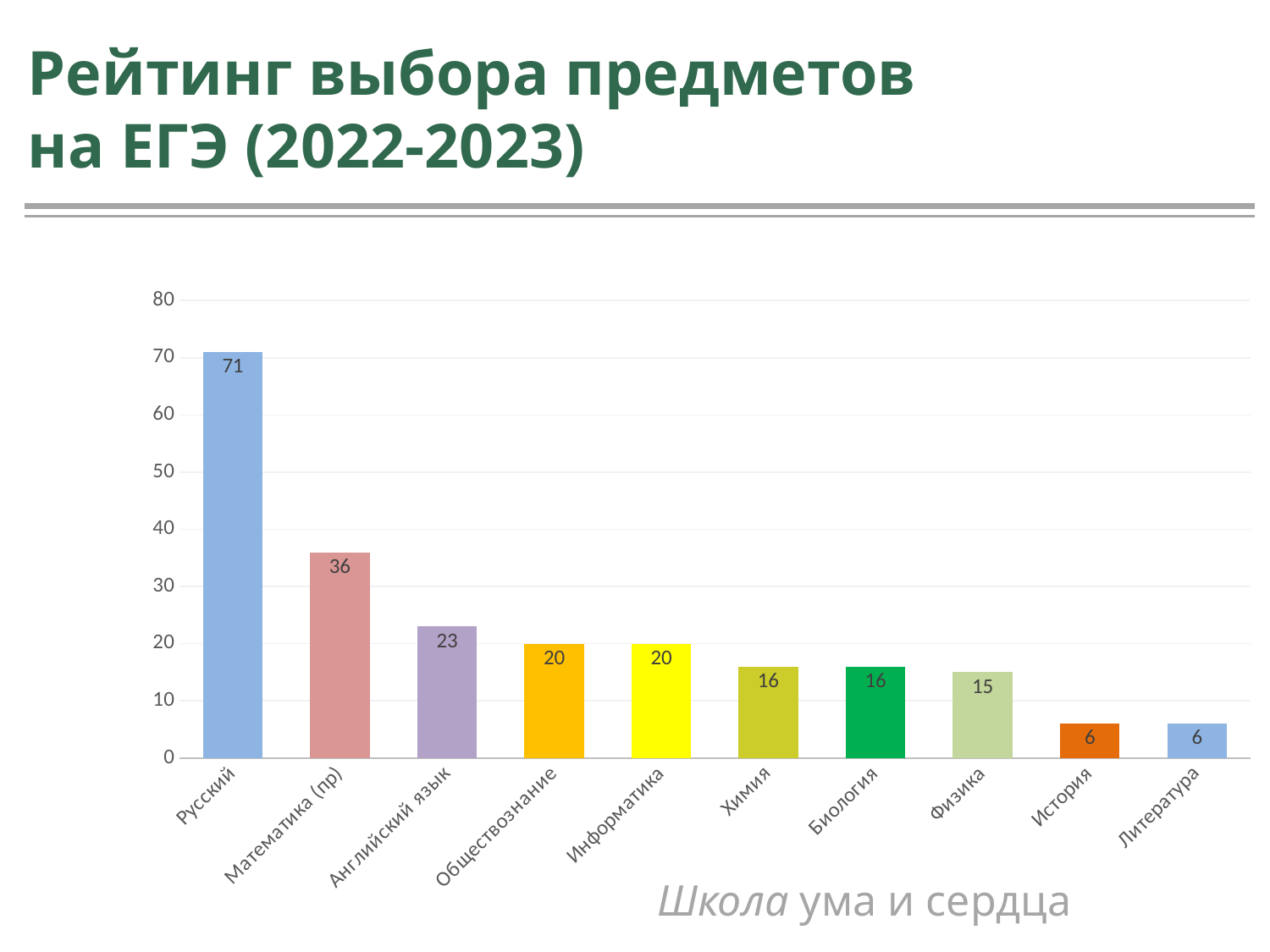
How many subjects are shown on the chart? 10 What kind of chart is shown on the slide? bar chart What is the value for Русский? 71 What is the value for Математика (пр)? 36 What is the difference between the values for Русский and Математика (пр)? 35 What is the value for Литература? 6 What is the value for Физика? 15 Is the value for Математика (пр) greater or less than 30? greater Which subject has the highest value? Русский Do the values rise or fall from left to right along the x axis? fall Which is larger, the value for Английский язык or the value for Обществознание? Английский язык What is the difference between the values for Английский язык and Химия? 7